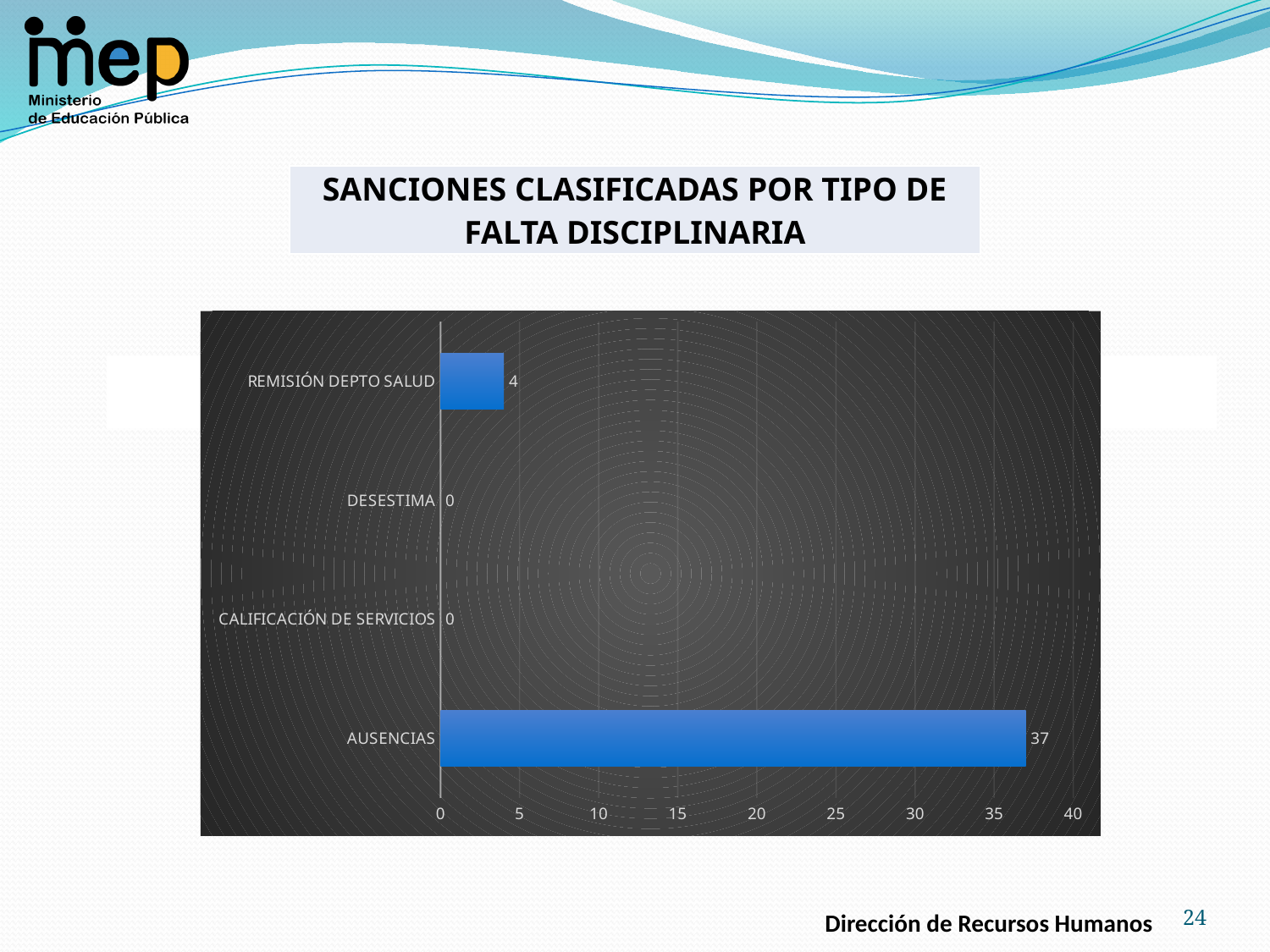
Is the value for AUSENCIAS greater or less than 35? greater What is the title of the chart? SANCIONES CLASIFICADAS POR TIPO DE FALTA DISCIPLINARIA What is the value for DESESTIMA? 0 What is the value for REMISIÓN DEPTO SALUD? 4 Which category has the highest value? AUSENCIAS What kind of chart is shown on the slide? Bar chart What is the value for CALIFICACIÓN DE SERVICIOS? 0 Is the value for REMISIÓN DEPTO SALUD greater or less than 5? less Which is larger, the value for AUSENCIAS or the value for REMISIÓN DEPTO SALUD? AUSENCIAS What is the difference between the values for AUSENCIAS and REMISIÓN DEPTO SALUD? 33 How many categories are shown in the chart? 4 What is the value for AUSENCIAS? 37